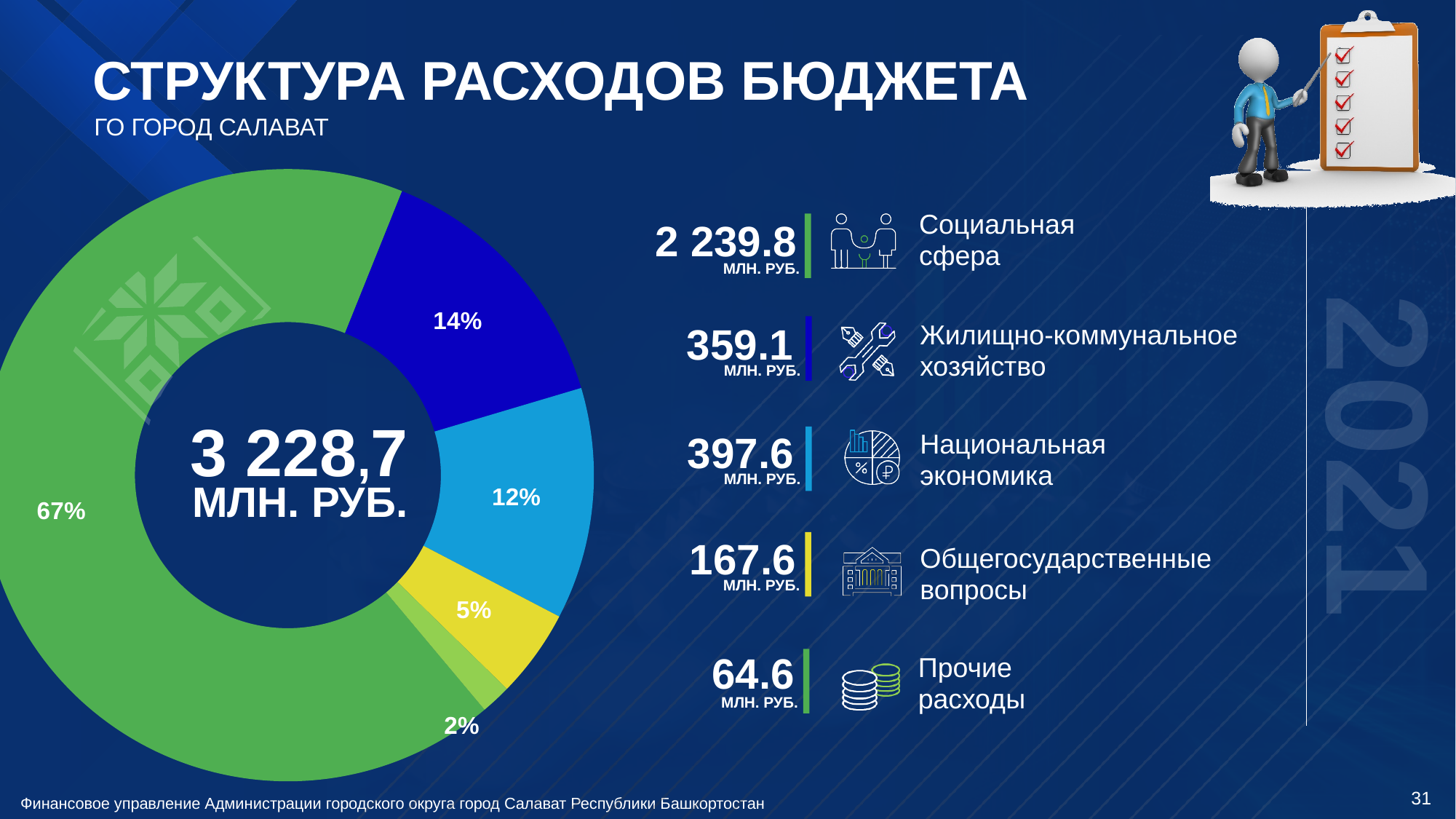
What percentage is shown on the dark blue slice of the donut chart? 14% How many slices does the donut chart have? 5 Which is larger: the value for Национальная экономика or for Жилищно-коммунальное хозяйство? Национальная экономика What is the value listed for Социальная сфера? 2 239.8 млн. руб. What kind of chart is shown on the slide? pie chart (donut) What percentage is shown on the green slice of the donut chart? 67% What percentage is shown on the light blue slice of the donut chart? 12% What is the value listed for Общегосударственные вопросы? 167.6 млн. руб. Which category has the smallest value listed on the slide? Прочие расходы What total value is printed in the centre of the donut chart? 3 228,7 млн. руб.